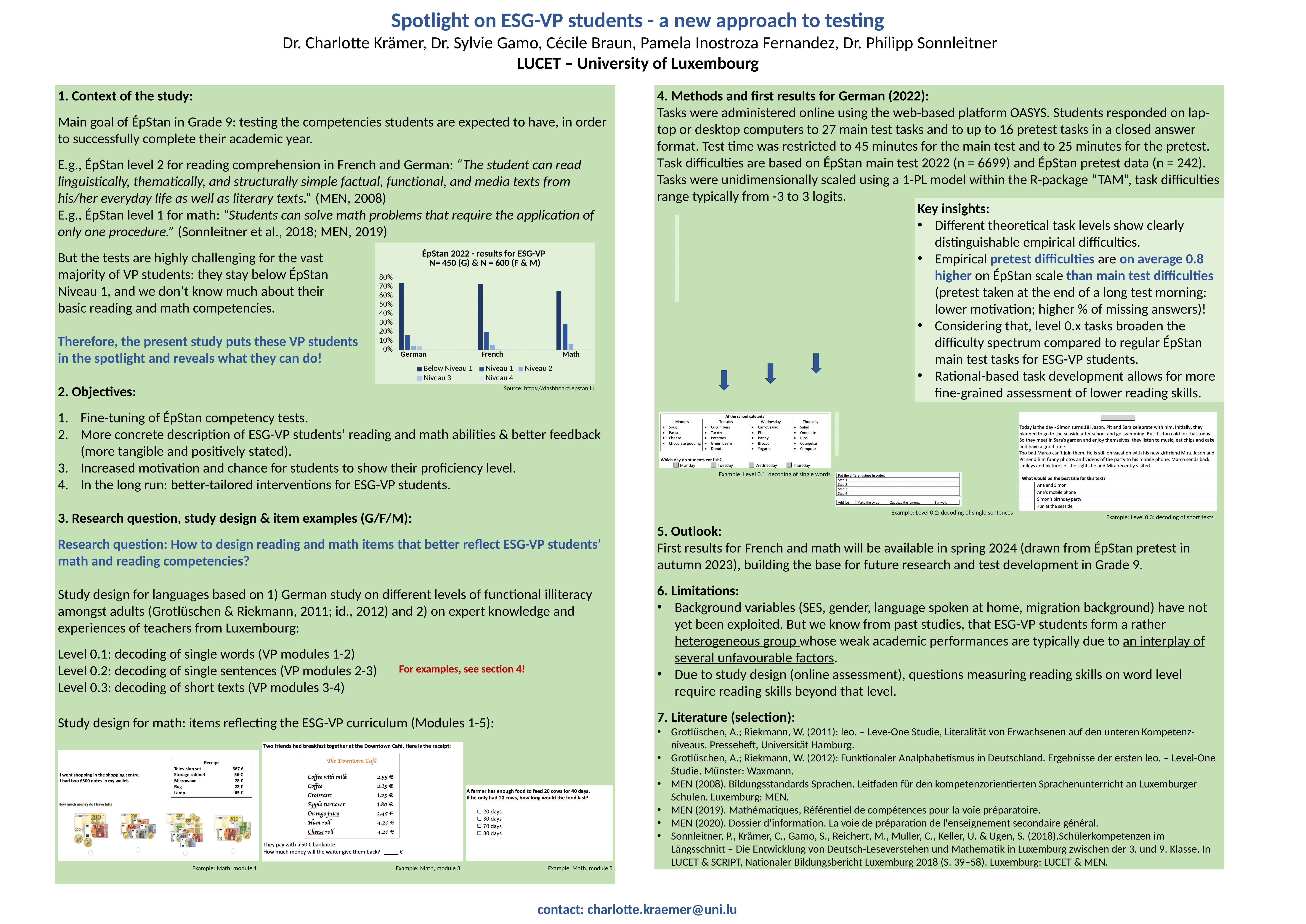
Does the value for Niveau 1 rise or fall from German to French to Math? rise How many series does the chart's legend list? 5 Is the value for Below Niveau 1 in Math greater or less than 50%? greater What kind of chart is shown on the slide? bar chart How many categories are shown on the x axis of the chart? 3 Which series is listed first in the chart's legend? Below Niveau 1 Is the value for Below Niveau 1 in German greater or less than 60%? greater In the German category, which is larger: Below Niveau 1 or Niveau 1? Below Niveau 1 What is the title of the chart? ÉpStan 2022 - results for ESG-VP N= 450 (G) & N = 600 (F & M) Is the value for Niveau 1 in Math greater or less than 40%? less Which category has the highest value for Niveau 1? Math Which category has the lowest value for Below Niveau 1? Math